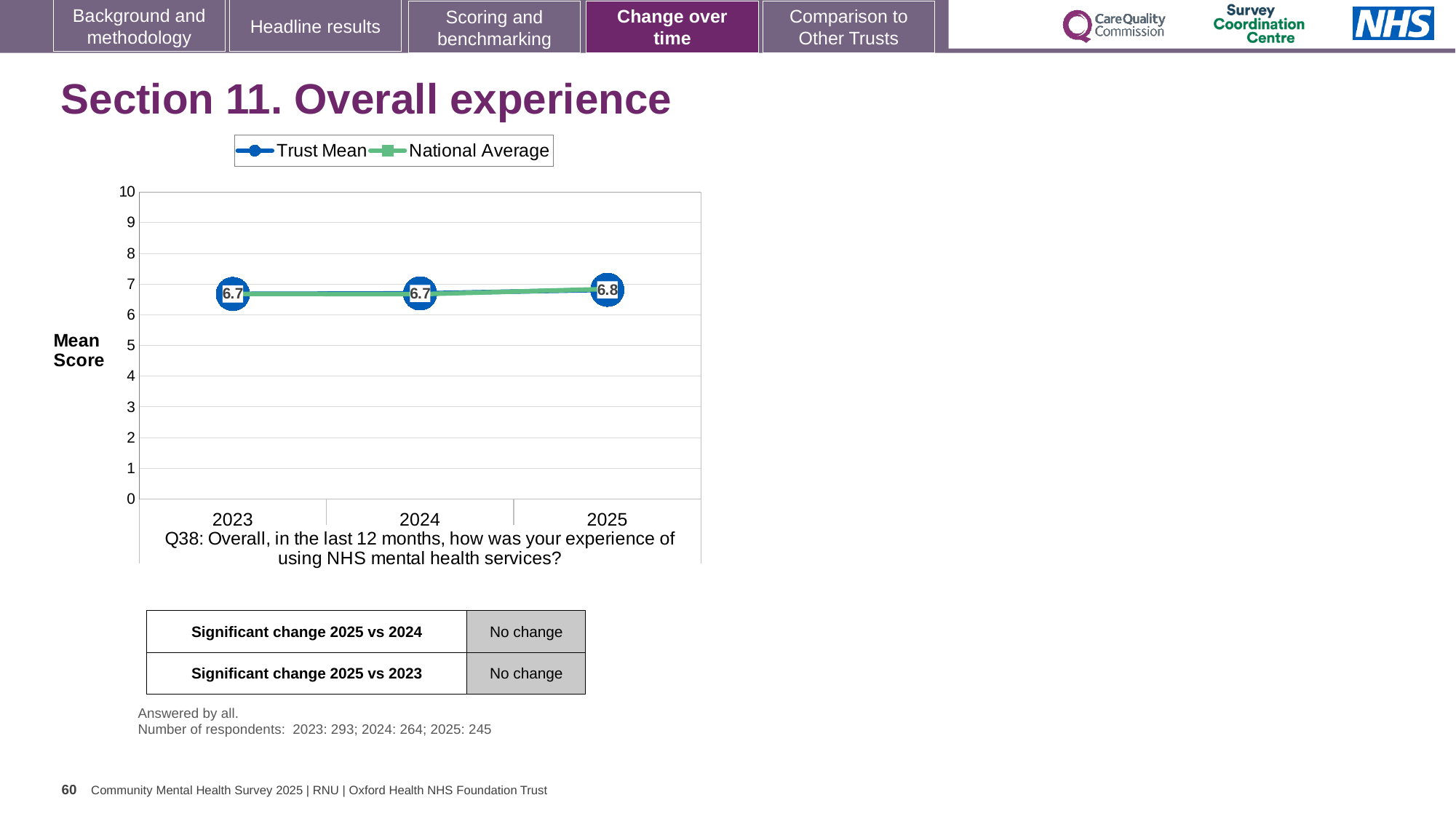
How many series does the legend list? 2 What is the Trust Mean score for 2023? 6.7 In which year is the Trust Mean score highest? 2025 Is the National Average value for 2023 greater or less than 5? greater Which is larger, the Trust Mean score for 2025 or for 2024? 2025 What is the Trust Mean score for 2025? 6.8 Does the Trust Mean score rise or fall from 2023 to 2025? Rise What is the difference between the Trust Mean score in 2025 and in 2023? 0.1 What kind of chart is shown on the slide? Line chart How many years are plotted on the x axis? 3 Is the Trust Mean value for 2024 greater or less than 8? less What is the Trust Mean score for 2024? 6.7